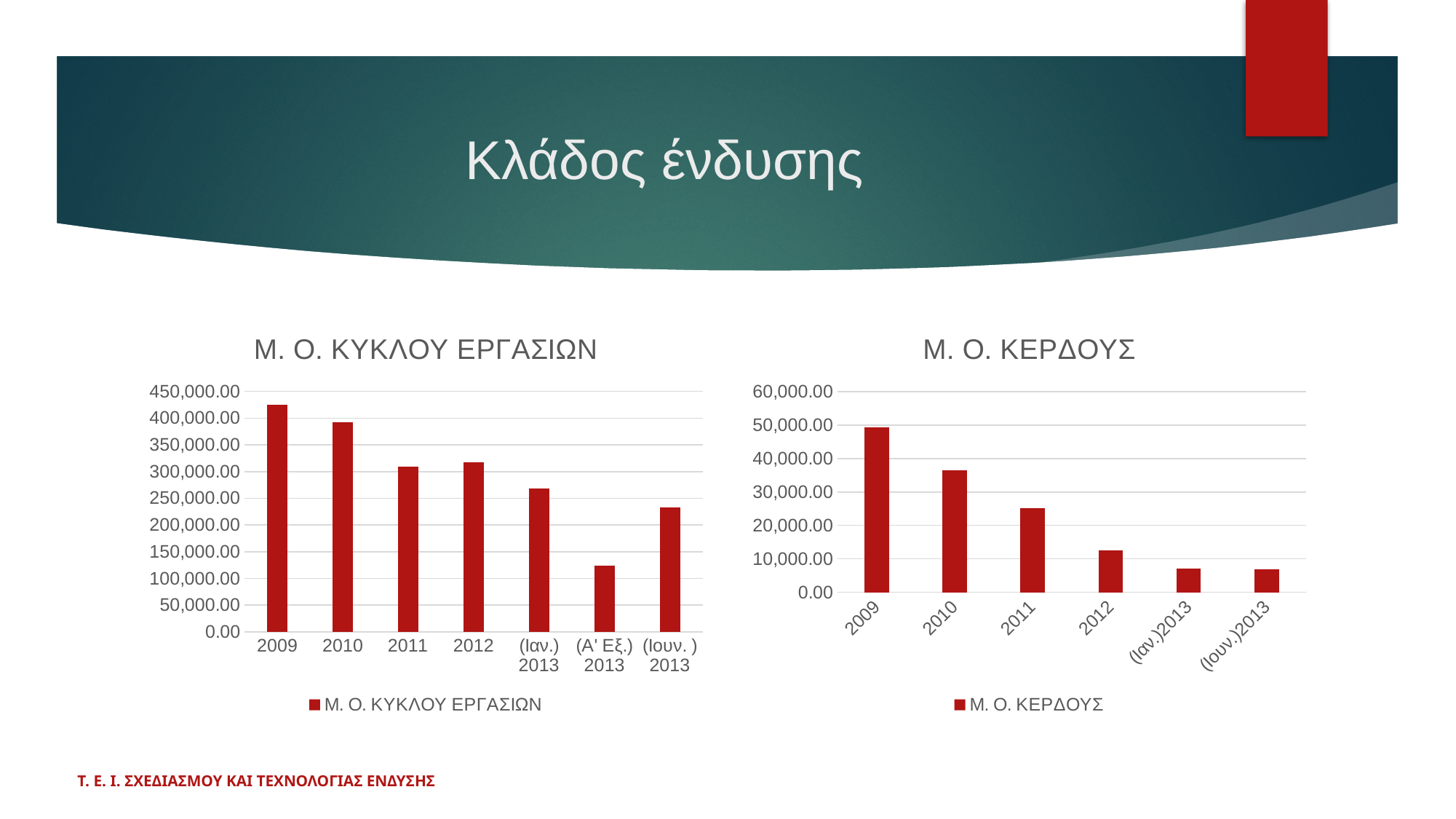
In the chart titled Μ. Ο. ΚΕΡΔΟΥΣ, which category has the highest value? 2009 In the chart titled Μ. Ο. ΚΥΚΛΟΥ ΕΡΓΑΣΙΩΝ, which category has the highest value? 2009 What is the title of the chart on the right side of the slide? Μ. Ο. ΚΕΡΔΟΥΣ How many categories are shown on the x axis of the chart titled Μ. Ο. ΚΕΡΔΟΥΣ? 6 What kind of chart is the chart titled Μ. Ο. ΚΥΚΛΟΥ ΕΡΓΑΣΙΩΝ? Bar chart In the chart titled Μ. Ο. ΚΕΡΔΟΥΣ, do the values generally rise or fall from 2009 to (Ιουν.)2013? fall In the chart titled Μ. Ο. ΚΕΡΔΟΥΣ, is the value for 2012 greater or less than 20,000.00? less In the chart titled Μ. Ο. ΚΥΚΛΟΥ ΕΡΓΑΣΙΩΝ, which is larger, the value for 2009 or the value for 2010? 2009 In the chart titled Μ. Ο. ΚΥΚΛΟΥ ΕΡΓΑΣΙΩΝ, is the value for 2009 greater or less than 400,000.00? greater In the chart titled Μ. Ο. ΚΥΚΛΟΥ ΕΡΓΑΣΙΩΝ, which category has the lowest value? (Α' Εξ.) 2013 How many series does the legend of the chart titled Μ. Ο. ΚΕΡΔΟΥΣ list? 1 How many categories are shown on the x axis of the chart titled Μ. Ο. ΚΥΚΛΟΥ ΕΡΓΑΣΙΩΝ? 7